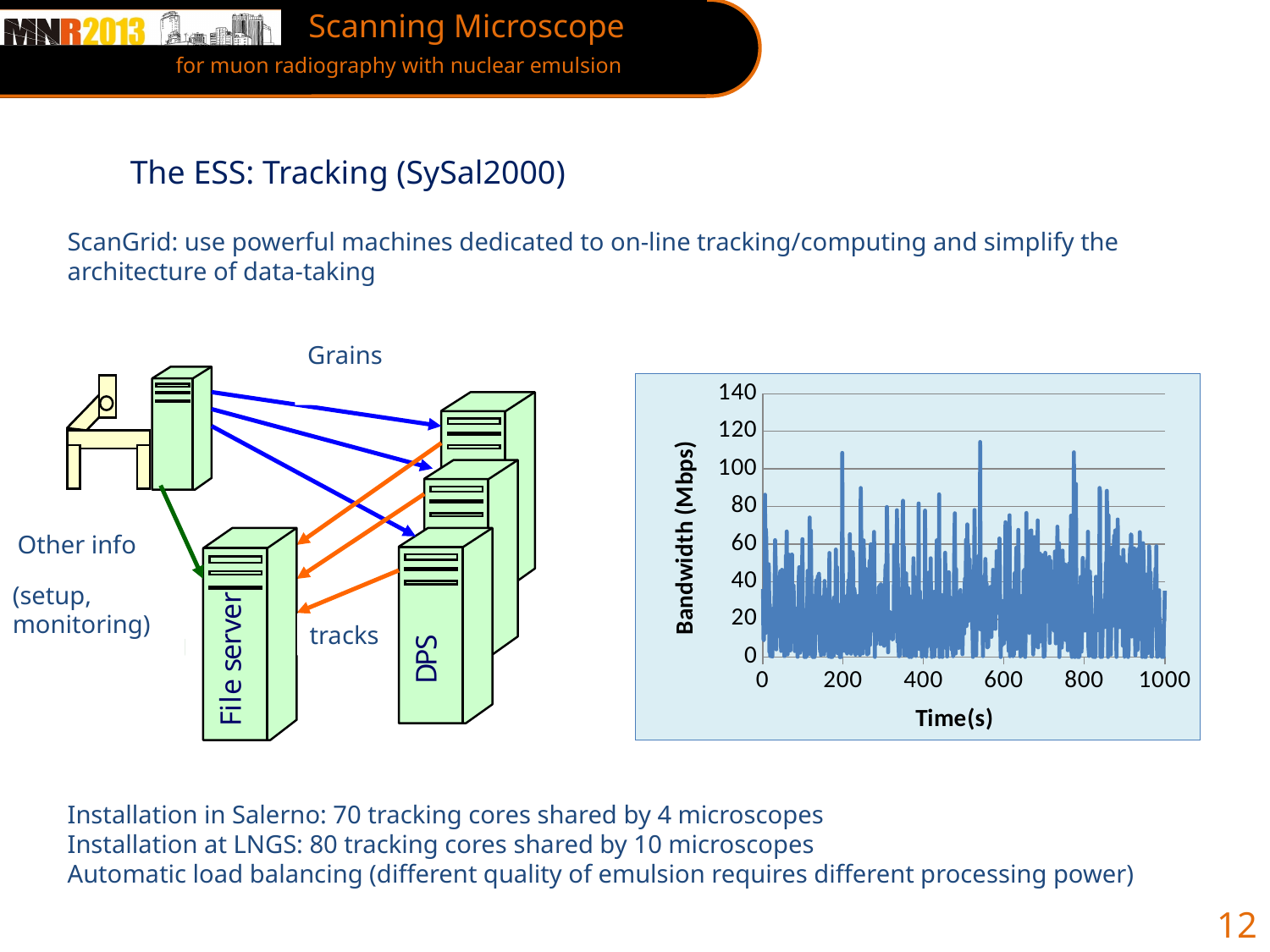
Is the highest bandwidth value plotted in the chart greater or less than 140? less What is the label of the vertical axis of the chart? Bandwidth (Mbps) What kind of chart is shown on the right of the slide? line chart What is the label of the horizontal axis of the chart? Time(s) Is the highest bandwidth value plotted in the chart greater or less than 100? greater